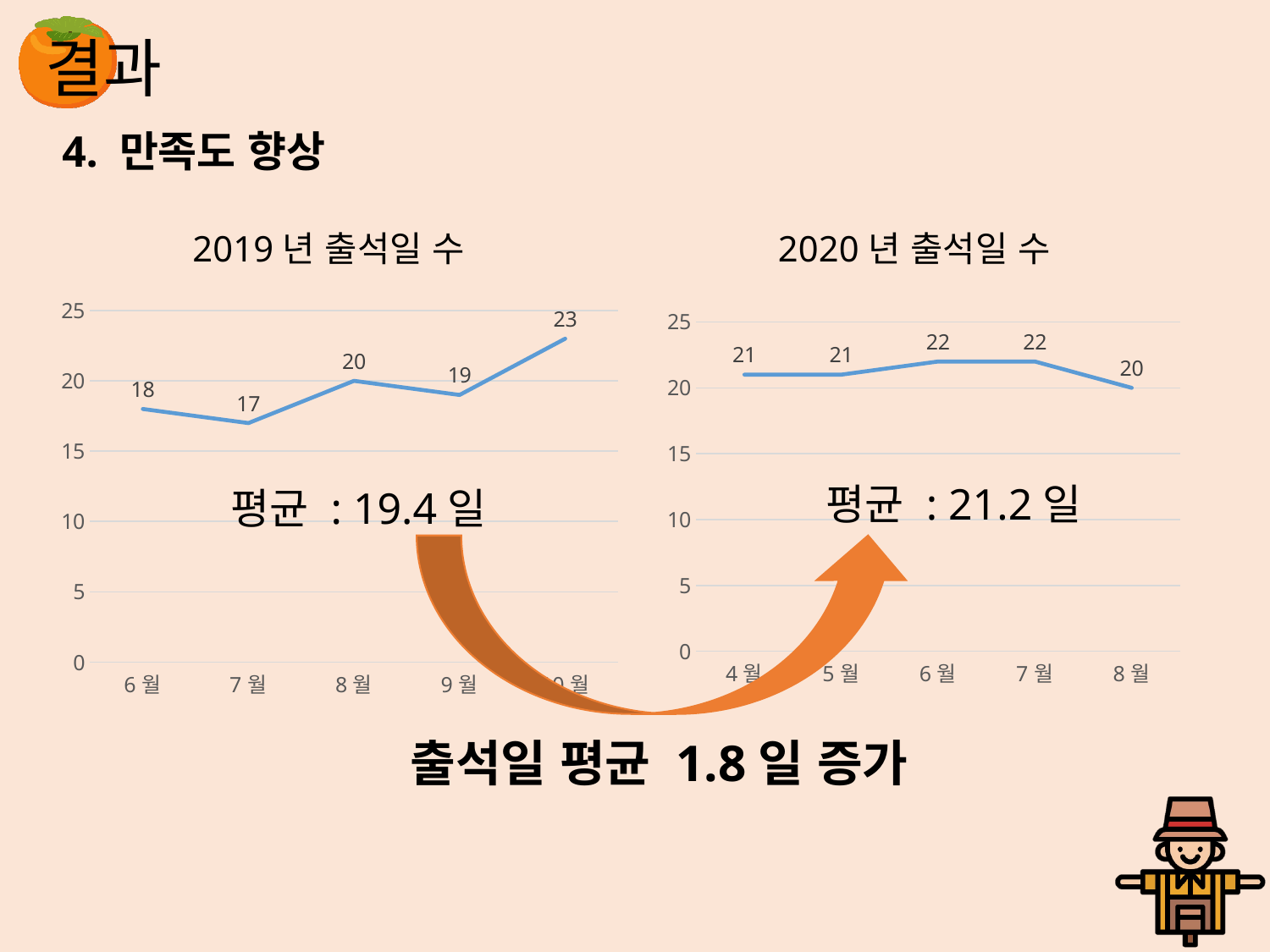
In the 2019 년 출석일 수 chart, what is the value for 6 월? 18 In the 2020 년 출석일 수 chart, what is the value for 6 월? 22 In the 2020 년 출석일 수 chart, which month has the lowest value? 8 월 What kind of chart is the 2019 년 출석일 수 chart? line chart In the 2019 년 출석일 수 chart, what is the value for 8 월? 20 In the 2019 년 출석일 수 chart, which month has the lowest value? 7 월 What is the title of the chart on the right side of the slide? 2020 년 출석일 수 In the 2020 년 출석일 수 chart, what is the value for 8 월? 20 In the 2020 년 출석일 수 chart, which is larger, the value for 4 월 or the value for 7 월? 7 월 In the 2019 년 출석일 수 chart, what is the highest value plotted? 23 In the 2019 년 출석일 수 chart, what is the difference between the values for 8 월 and 7 월? 3 In the 2020 년 출석일 수 chart, how many months are plotted? 5